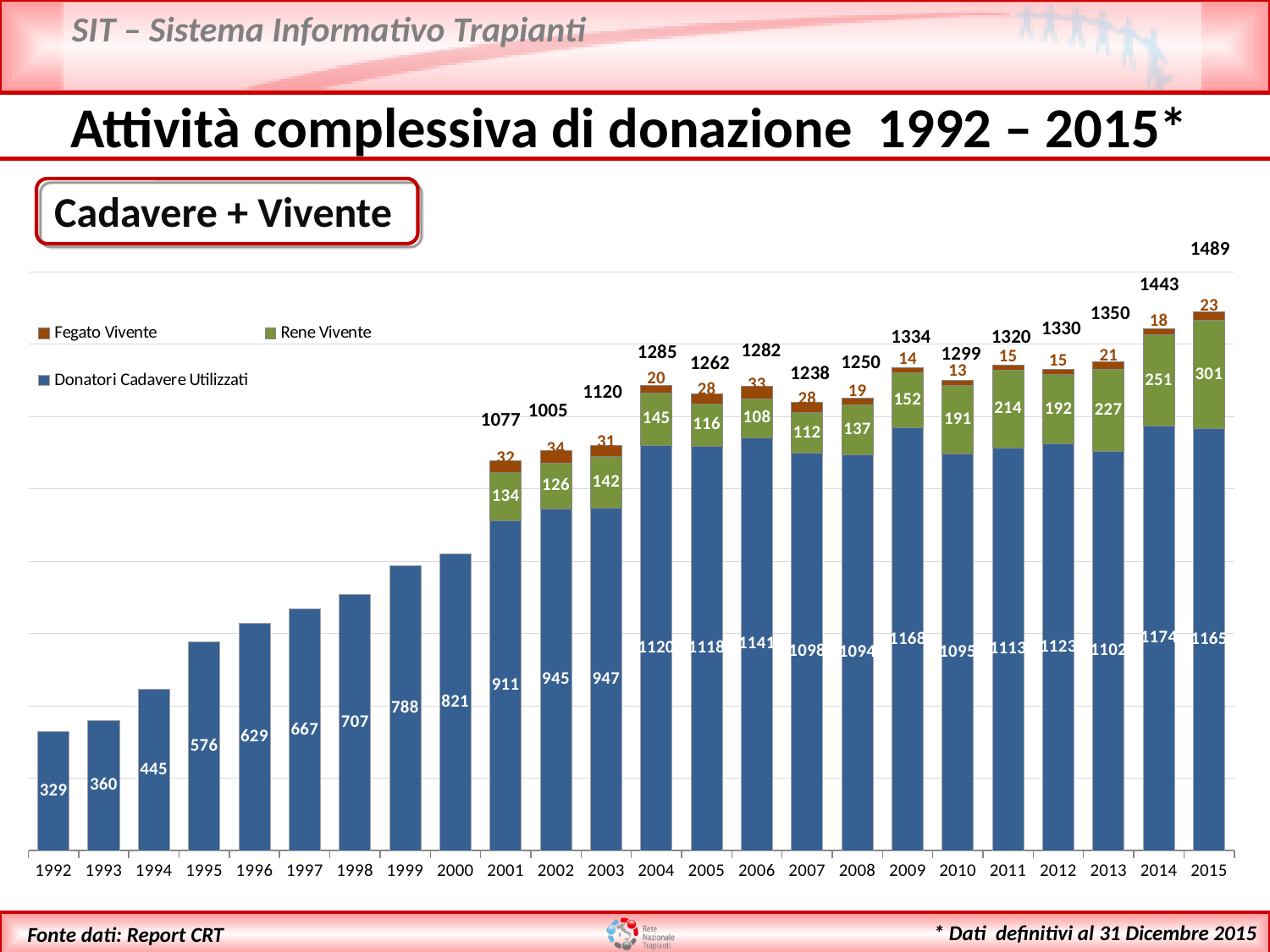
What is the Rene Vivente value for 2015? 301 Which year has the highest total bar? 2015 What is the value of Donatori Cadavere Utilizzati for 1992? 329 Do the Donatori Cadavere Utilizzati values rise or fall from 1992 to 2000? rise Which year has the lowest value for Donatori Cadavere Utilizzati? 1992 What is the difference between the Rene Vivente values for 2015 and 2014? 50 Which is larger, the Donatori Cadavere Utilizzati value for 2004 or for 2015? 2015 How many years are shown on the x axis? 24 What is the total printed above the bar for 2015? 1489 How many series does the legend list? 3 What is the Fegato Vivente value for 2013? 21 What is the difference between the totals for 2015 and 2014? 46